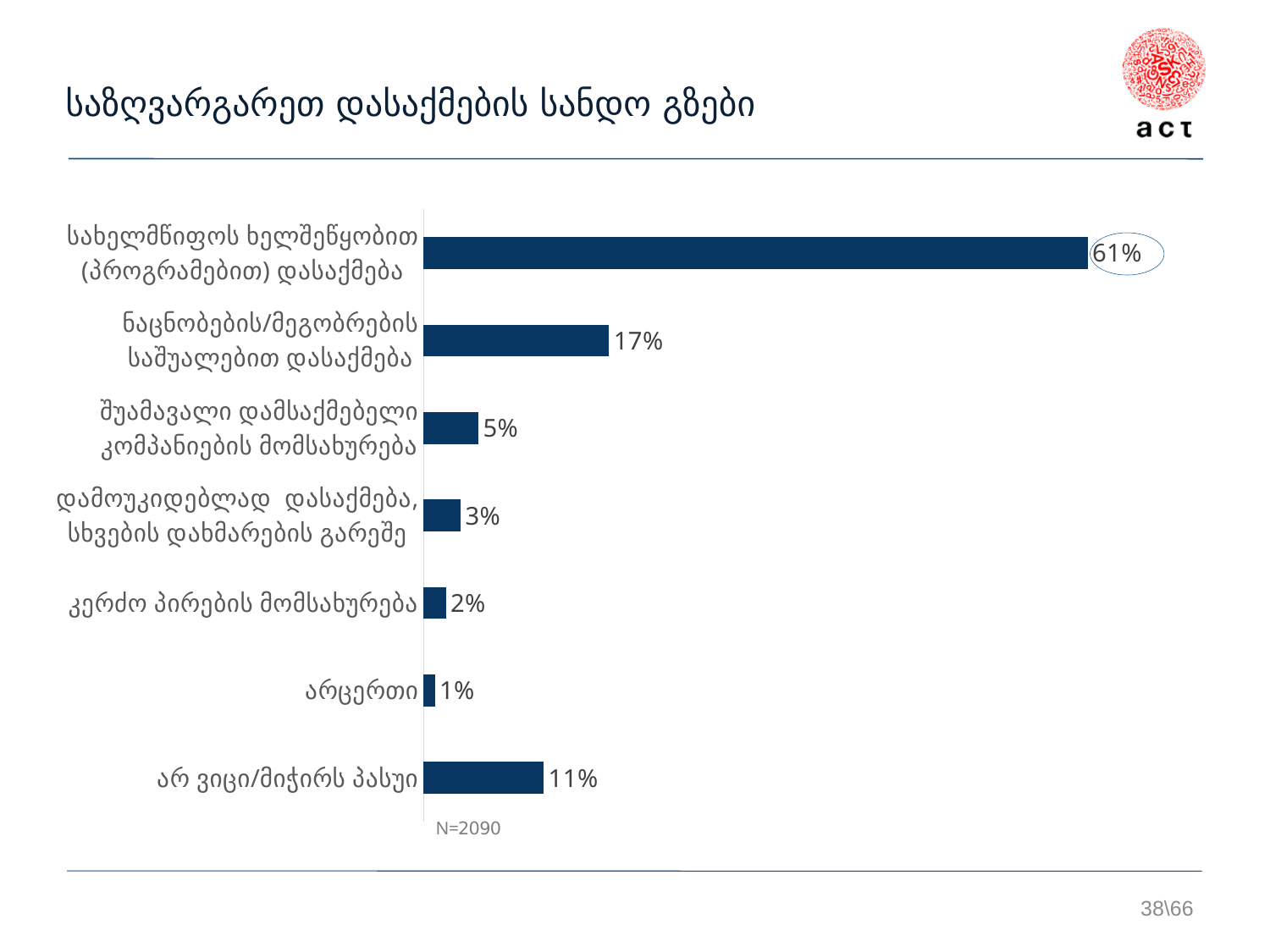
What value is shown for "სახელმწიფოს ხელშეწყობით (პროგრამებით) დასაქმება"? 61% What is the difference between the values for "შუამავალი დამსაქმებელი კომპანიების მომსახურება" and "დამოუკიდებლად დასაქმება, სხვების დახმარების გარეშე"? 2% Which is larger: the value for "არ ვიცი/მიჭირს პასუხი" or the value for "შუამავალი დამსაქმებელი კომპანიების მომსახურება"? არ ვიცი/მიჭირს პასუხი What value is shown for "არ ვიცი/მიჭირს პასუხი"? 11% Which category has the highest value? სახელმწიფოს ხელშეწყობით (პროგრამებით) დასაქმება What value is shown for "კერძო პირების მომსახურება"? 2% What sample size (N) is noted below the chart? N=2090 What value is shown for "ნაცნობების/მეგობრების საშუალებით დასაქმება"? 17% Which category has the lowest value? არცერთი What is the difference between the values for "სახელმწიფოს ხელშეწყობით (პროგრამებით) დასაქმება" and "ნაცნობების/მეგობრების საშუალებით დასაქმება"? 44% How many categories are shown in the chart? 7 What type of chart is shown on the slide? Bar chart